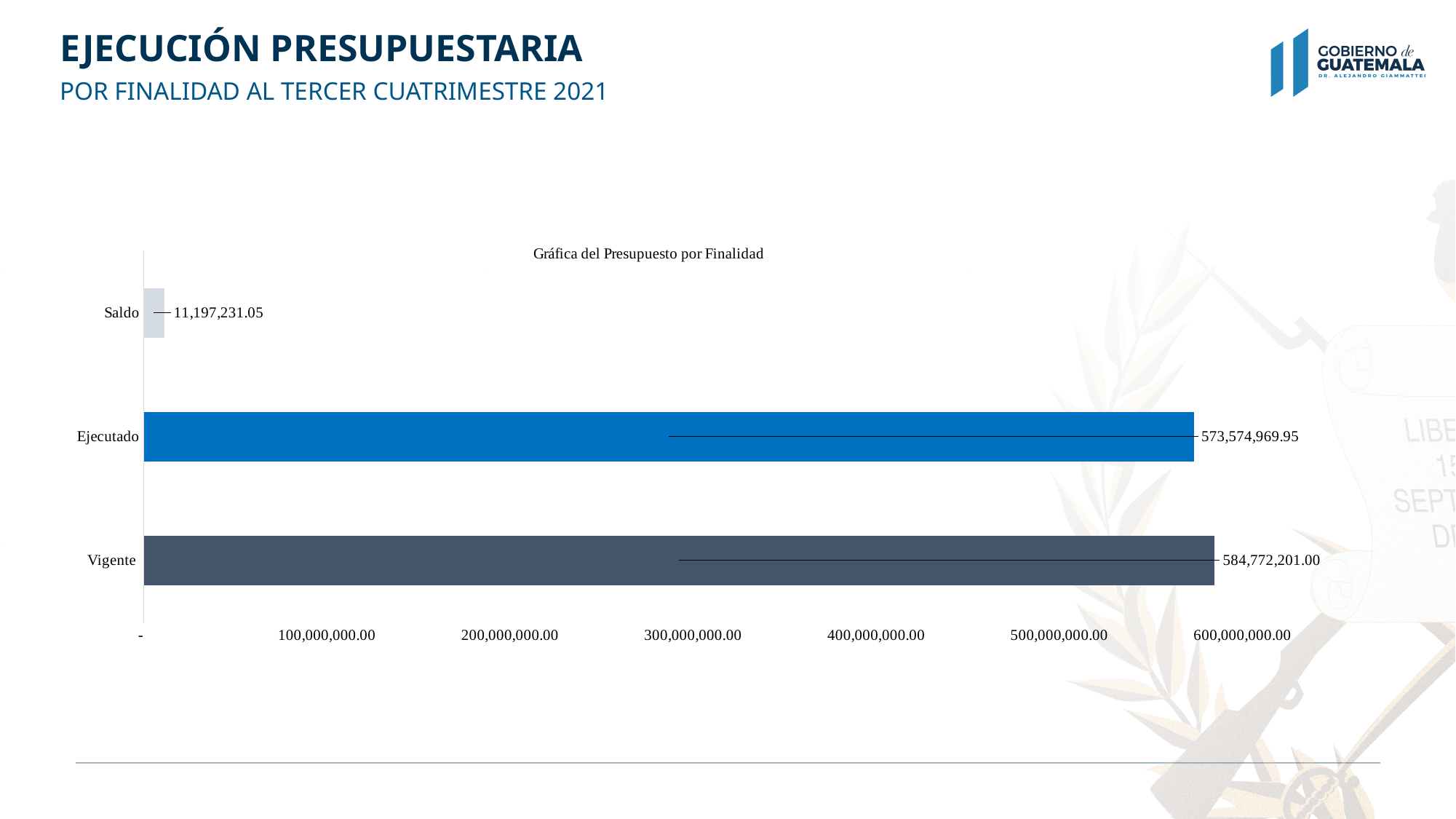
What is the value for Vigente? 584,772,201.00 Which category has the highest value? Vigente What is the value for Saldo? 11,197,231.05 What is the difference between the values for Ejecutado and Saldo? 562,377,738.90 Is the value for Ejecutado greater or less than 500,000,000.00? greater What is the difference between the values for Vigente and Ejecutado? 11,197,231.05 What is the title of the chart? Gráfica del Presupuesto por Finalidad Which is larger, the value for Ejecutado or the value for Saldo? Ejecutado Which category has the lowest value? Saldo What is the value for Ejecutado? 573,574,969.95 How many categories are shown in the chart? 3 What kind of chart is shown on the slide? Bar chart